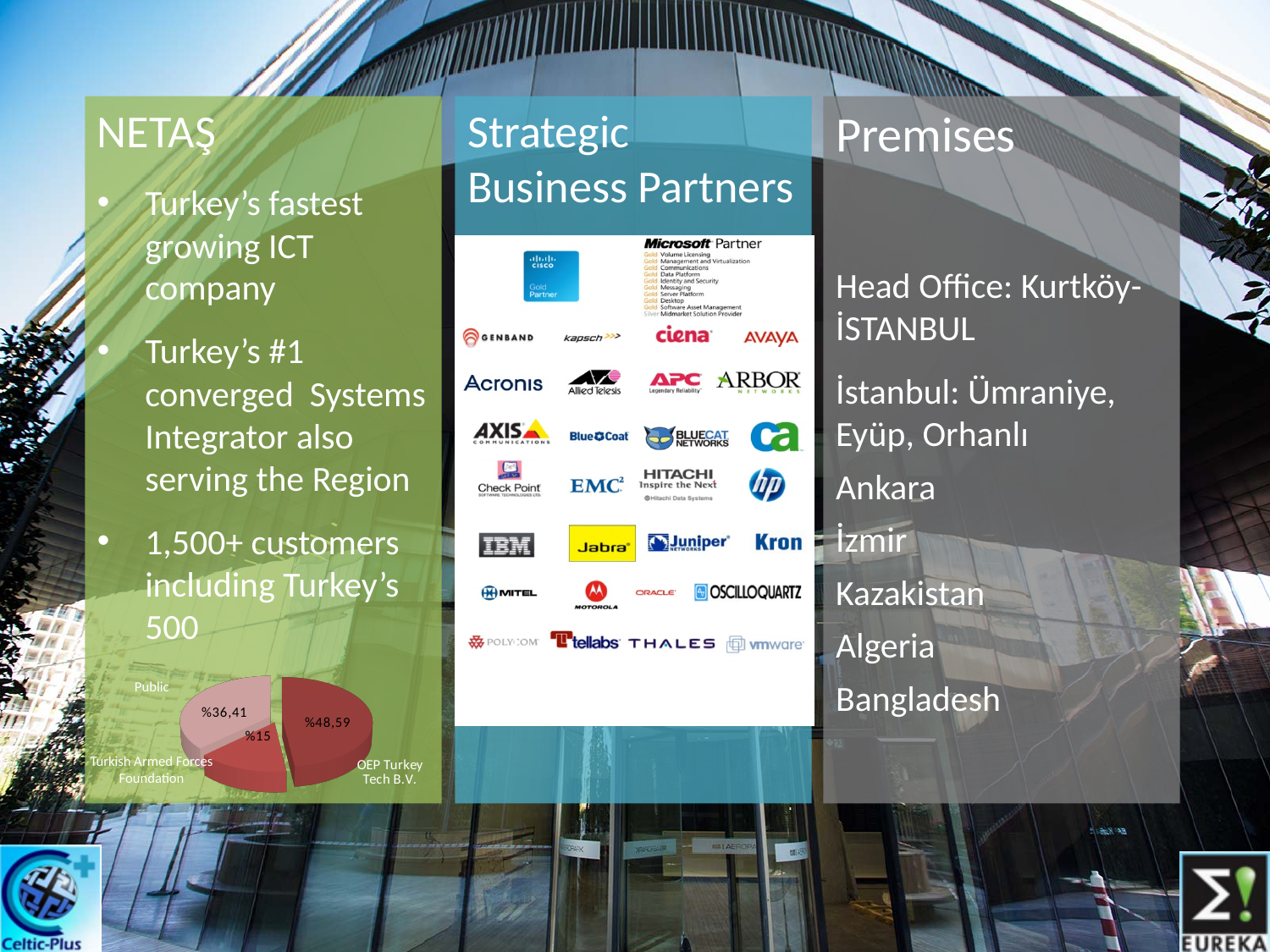
What is the value shown for the Public slice in the pie chart? %36,41 Is the OEP Turkey Tech B.V. share in the pie chart greater or less than 50%? less What is the value shown for the OEP Turkey Tech B.V. slice in the pie chart? %48,59 Which slice is larger in the pie chart, Public or Turkish Armed Forces Foundation? Public What is the value shown for the Turkish Armed Forces Foundation slice in the pie chart? %15 Which category has the largest slice in the pie chart? OEP Turkey Tech B.V. Which category has the smallest slice in the pie chart? Turkish Armed Forces Foundation How many slices does the pie chart have? 3 What is the difference between the Public and Turkish Armed Forces Foundation values in the pie chart? %21,41 What kind of chart is shown at the bottom left of the slide? Pie chart What do the three slice values in the pie chart add up to? %100 What is the difference between the OEP Turkey Tech B.V. and Public values in the pie chart? %12,18